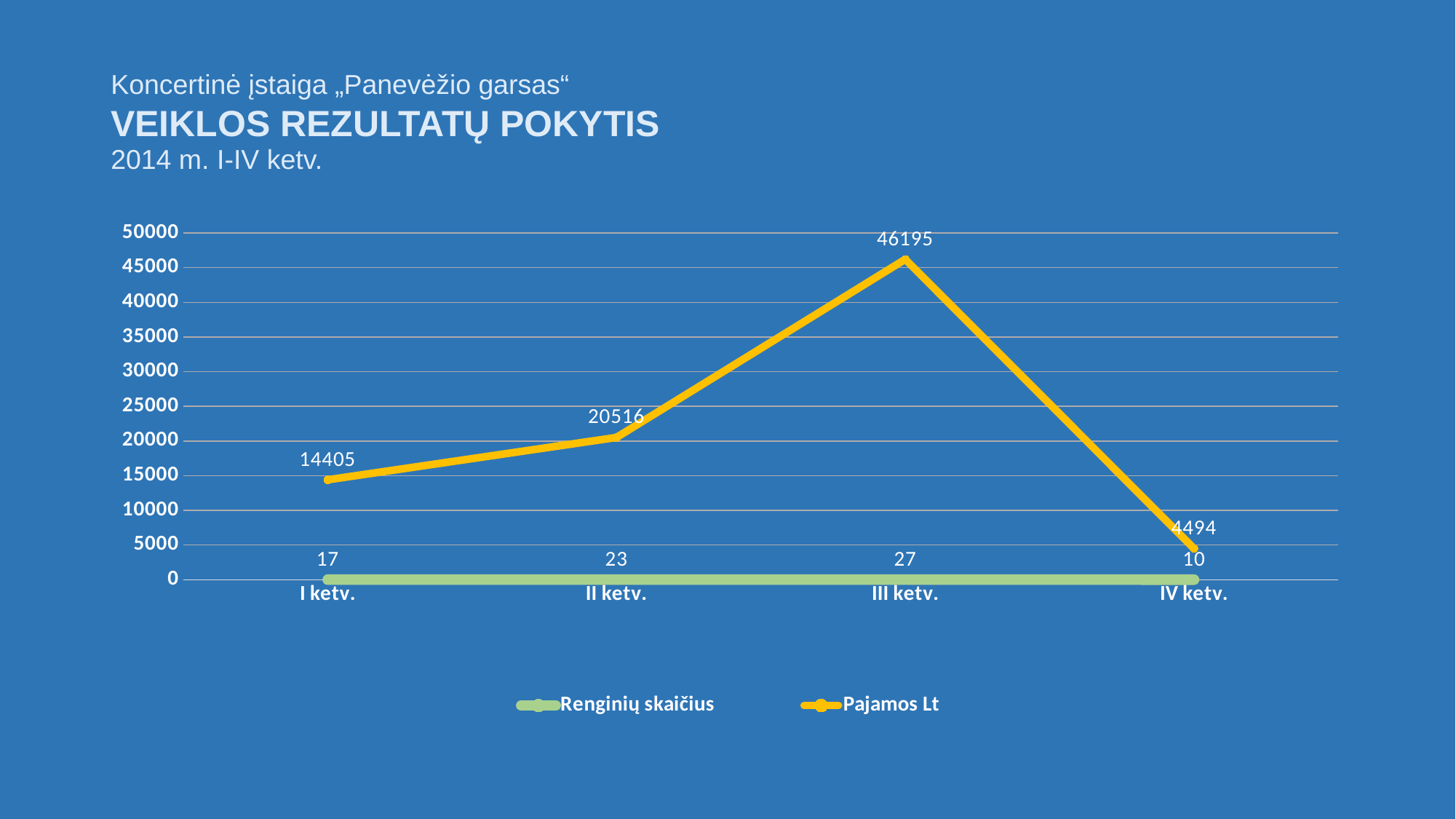
What is the value of Pajamos Lt for III ketv.? 46195 How many series does the legend list? 2 Which is larger, Renginių skaičius for I ketv. or for III ketv.? III ketv. Is the value of Pajamos Lt for I ketv. greater or less than 15000? less What is the difference in Pajamos Lt between III ketv. and II ketv.? 25679 Does Pajamos Lt rise or fall from III ketv. to IV ketv.? fall Which quarter has the highest Pajamos Lt? III ketv. How many quarters are shown on the x axis? 4 What kind of chart is shown on the slide? line chart What is the value of Renginių skaičius for II ketv.? 23 What is the value of Pajamos Lt for IV ketv.? 4494 Which quarter has the lowest Renginių skaičius? IV ketv.